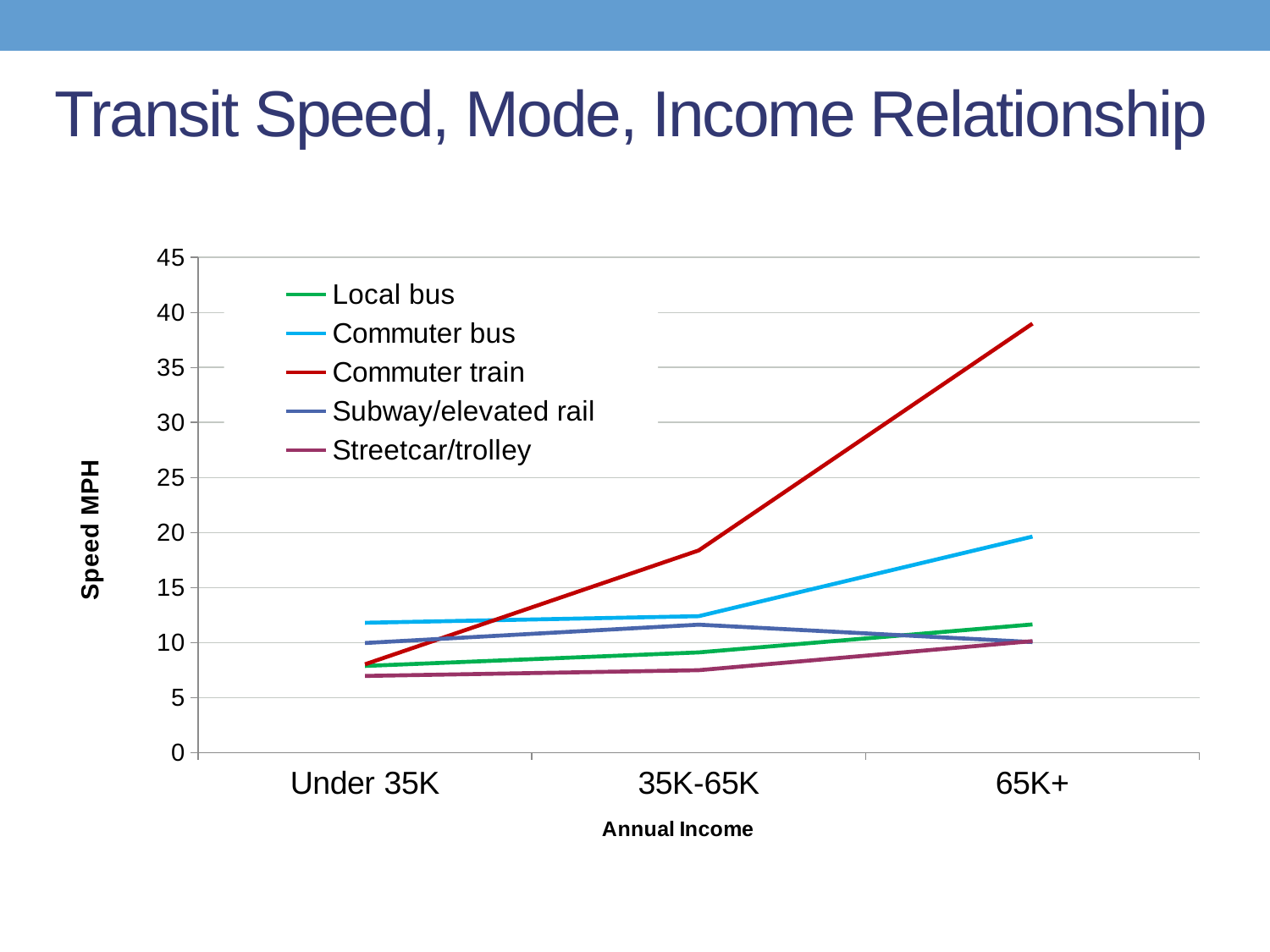
Which transit mode has the highest speed for the 65K+ income group? Commuter train What kind of chart is shown on the slide? Line chart Is the Commuter train speed for the Under 35K group greater or less than 10? less Which transit mode has the highest speed for the Under 35K income group? Commuter bus Is the Commuter train speed for the 65K+ group greater or less than 35? greater How many series does the legend list? 5 How many income categories are shown on the x axis? 3 Does the Commuter train speed rise or fall as annual income increases? Rises Which transit mode has the lowest speed for the 35K-65K income group? Streetcar/trolley For the Under 35K group, which is faster: Commuter bus or Commuter train? Commuter bus Is the Commuter bus speed for the 65K+ group greater or less than 15? greater What is the title of the vertical axis? Speed MPH